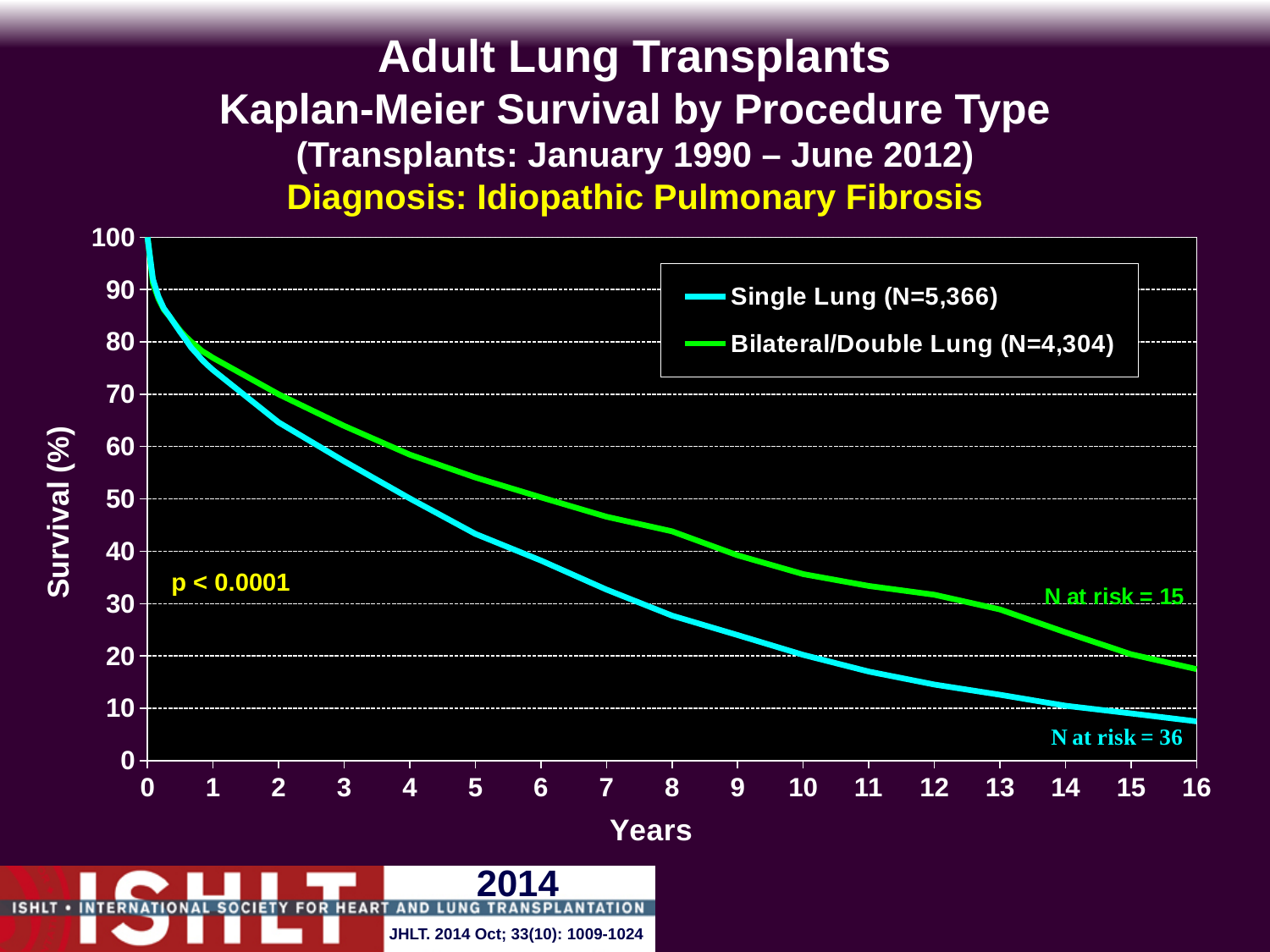
Is the survival value for Bilateral/Double Lung at 10 years greater or less than 30? greater How many series does the legend list? 2 What is the N at risk shown for the Bilateral/Double Lung series at the end of the curve? 15 Is the survival value for Single Lung at 3 years greater or less than 50? greater Is the survival value for Single Lung at 16 years greater or less than 10? less What kind of chart is shown on the slide? Line chart What p-value is printed on the chart? p < 0.0001 At 10 years, which procedure type has the higher survival, Single Lung or Bilateral/Double Lung? Bilateral/Double Lung What is the N at risk shown for the Single Lung series at the end of the curve? 36 Do the survival values rise or fall as the years increase along the x axis? Fall